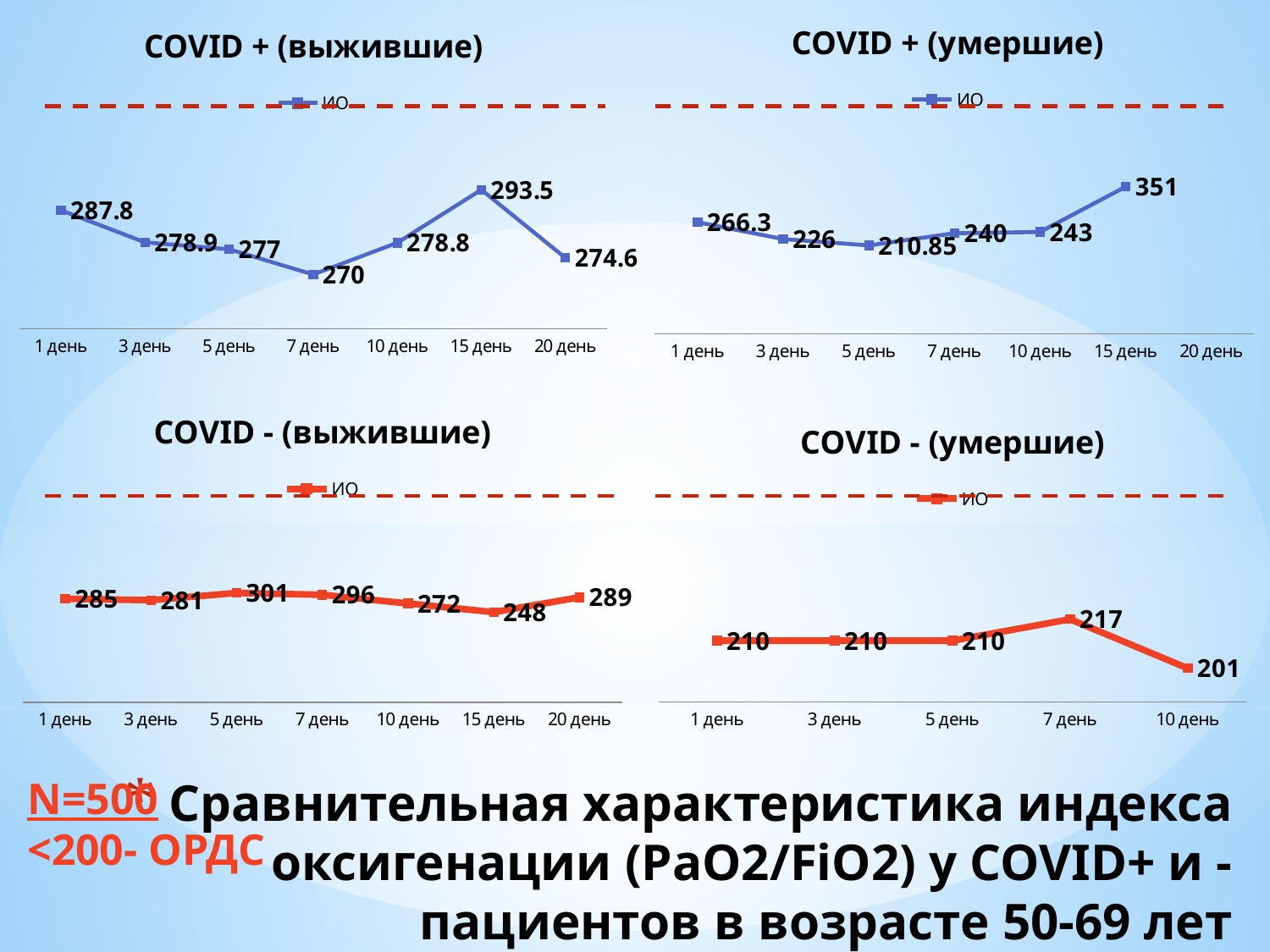
In the 'COVID - (умершие)' chart, how many days are shown on the x axis? 5 In the 'COVID + (выжившие)' chart, which day has the lowest value? 7 день In the 'COVID - (выжившие)' chart, what is the value for 5 день? 301 In the 'COVID + (умершие)' chart, which day has the highest value? 15 день In the 'COVID + (выжившие)' chart, what is the difference between the values for 1 день and 7 день? 17.8 How many series does the legend of the 'COVID + (выжившие)' chart list? 1 What type of chart is the 'COVID - (умершие)' chart? Line chart In the 'COVID + (умершие)' chart, which is larger, the value for 3 день or the value for 7 день? 7 день In the 'COVID - (умершие)' chart, what is the value for 10 день? 201 In the 'COVID - (выжившие)' chart, what is the difference between the values for 5 день and 15 день? 53 In the 'COVID + (умершие)' chart, what is the value for 5 день? 210.85 In the 'COVID + (выжившие)' chart, what is the value for 15 день? 293.5